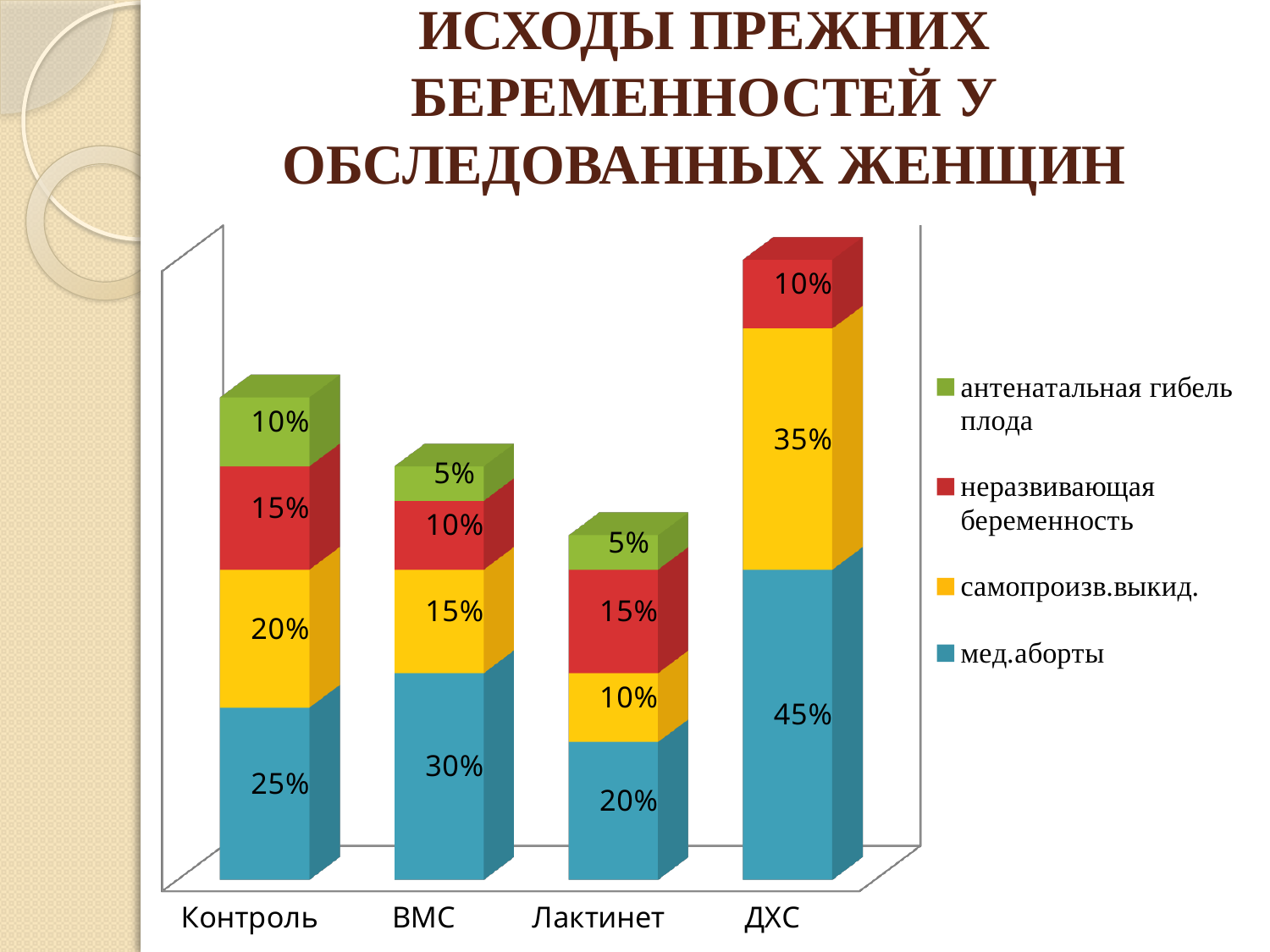
What is the value for антенатальная гибель плода in the ВМС category? 5% Which category has the lowest value for мед.аборты? Лактинет What kind of chart is shown on the slide? Stacked bar chart What is the value for самопроизв.выкид. in the ДХС category? 35% Which category has the highest value for мед.аборты? ДХС What is the value for неразвивающая беременность in the Лактинет category? 15% Which is larger: самопроизв.выкид. for Контроль or for ВМС? Контроль What is the total of the stacked bar for Контроль? 70% What is the value for мед.аборты in the Контроль category? 25% How many categories are shown on the x axis? 4 What is the difference between the мед.аборты values for ДХС and Контроль? 20% How many series does the legend list? 4